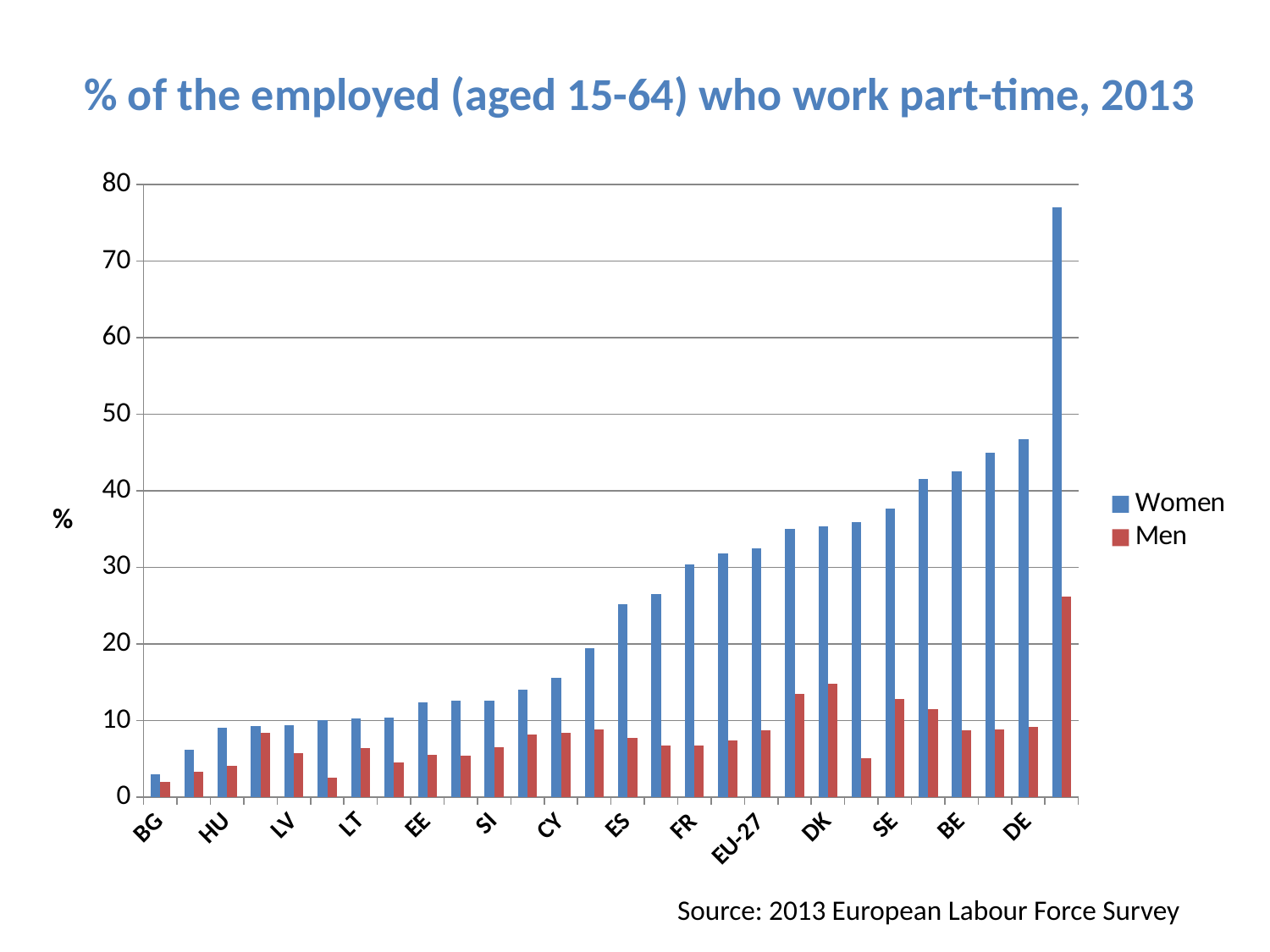
Is the Women value for BG greater or less than 10? less What is the title of the chart? % of the employed (aged 15-64) who work part-time, 2013 Is the Women value for DE greater or less than 40? greater Is the Men value for BE greater or less than 10? less Do the Women values rise or fall moving from left to right along the x axis? rise For DE, which is larger, the Women value or the Men value? Women How many series does the legend list? 2 Which series is shown in blue? Women What kind of chart is shown on the slide? Bar chart